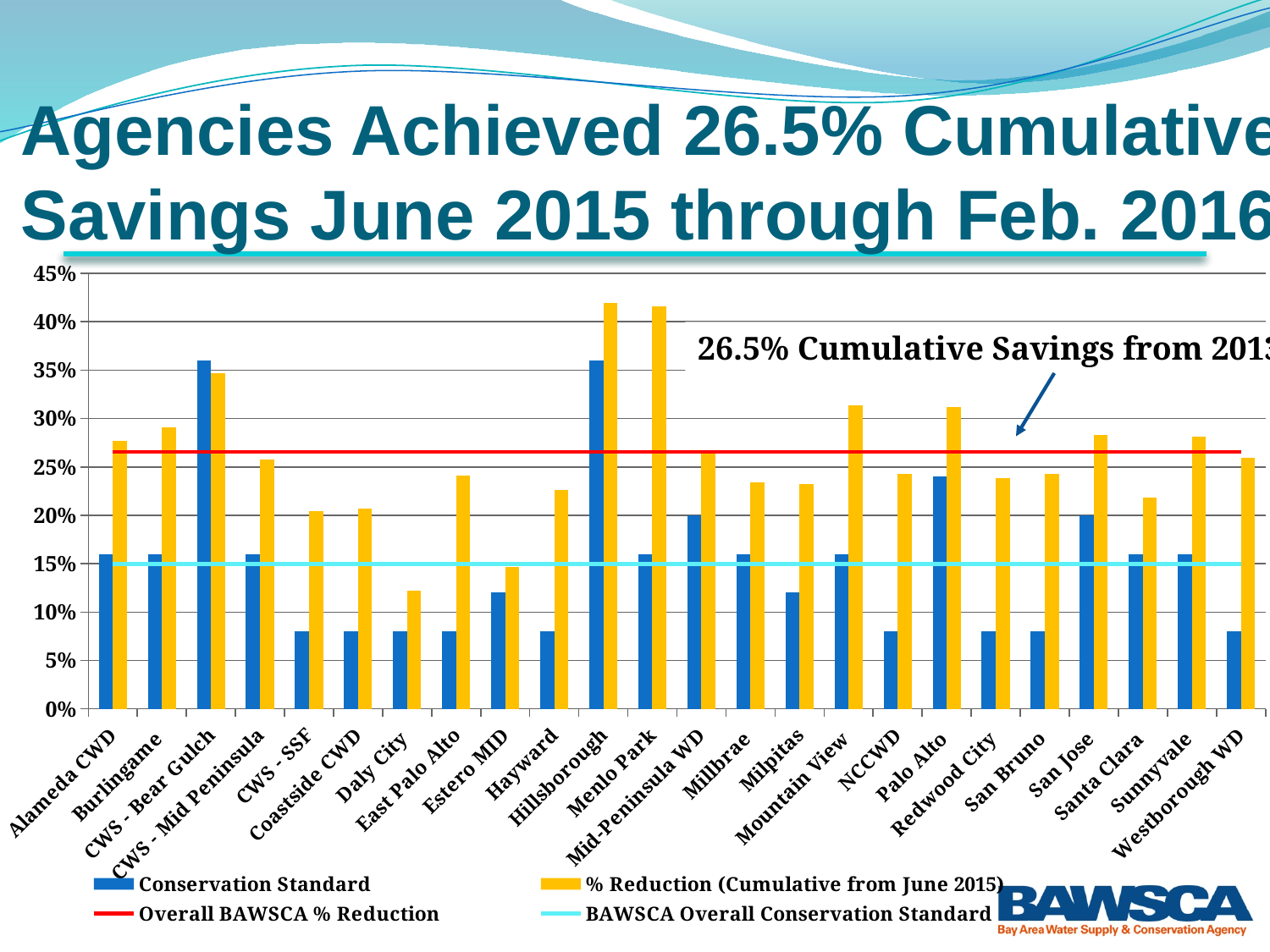
Is the % Reduction (Cumulative from June 2015) value for Mountain View greater or less than 30%? greater Is the % Reduction (Cumulative from June 2015) value for Hillsborough greater or less than 40%? greater How many series does the chart legend list? 4 Which has the larger Conservation Standard bar, CWS - Bear Gulch or CWS - SSF? CWS - Bear Gulch What kind of chart is shown on the slide? bar chart Is the Conservation Standard value for Palo Alto greater or less than 20%? greater What value does the red Overall BAWSCA % Reduction line represent, according to the annotation on the chart? 26.5% Which series in the legend is shown in blue? Conservation Standard Which agency has the lowest % Reduction (Cumulative from June 2015) bar? Daly City Which has the larger % Reduction (Cumulative from June 2015) bar, Mountain View or Millbrae? Mountain View How many agencies are listed along the x axis of the chart? 24